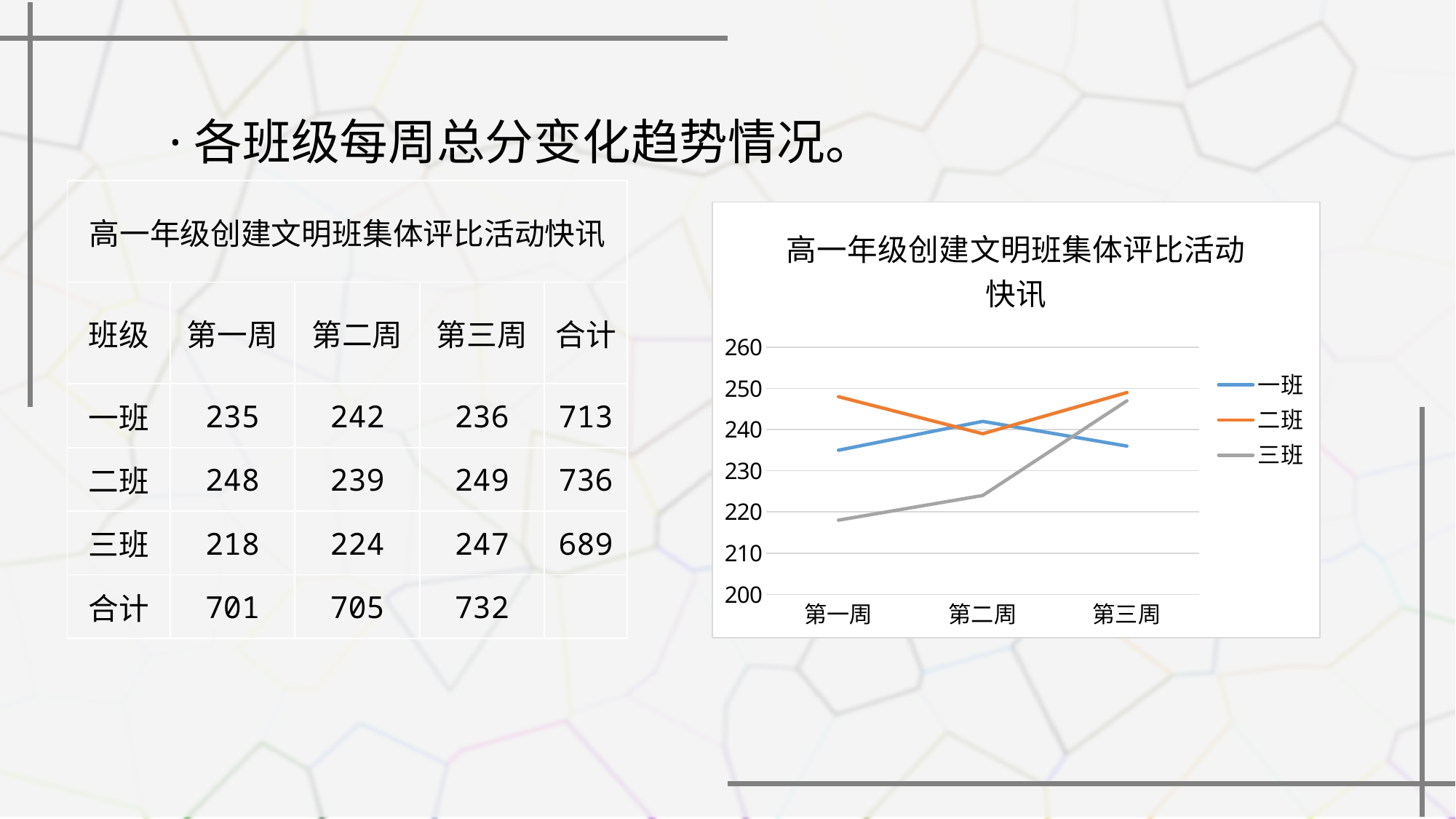
Which class has the lowest value in 第二周? 三班 How many series does the chart legend list? 3 Which class has the highest value in 第一周? 二班 Do the values for 三班 rise or fall from 第一周 to 第三周? rise Which is larger in 第三周, 一班 or 二班? 二班 Is the value for 三班 in 第一周 greater or less than 220? less Which colour is the line for 二班 in the chart? orange What is the difference between 二班 and 三班 in 第一周? 30 What kind of chart is shown on the slide? line chart What is the value for 三班 in 第一周? 218 How many points are on the x axis of the chart? 3 What is the value for 一班 in 第二周? 242